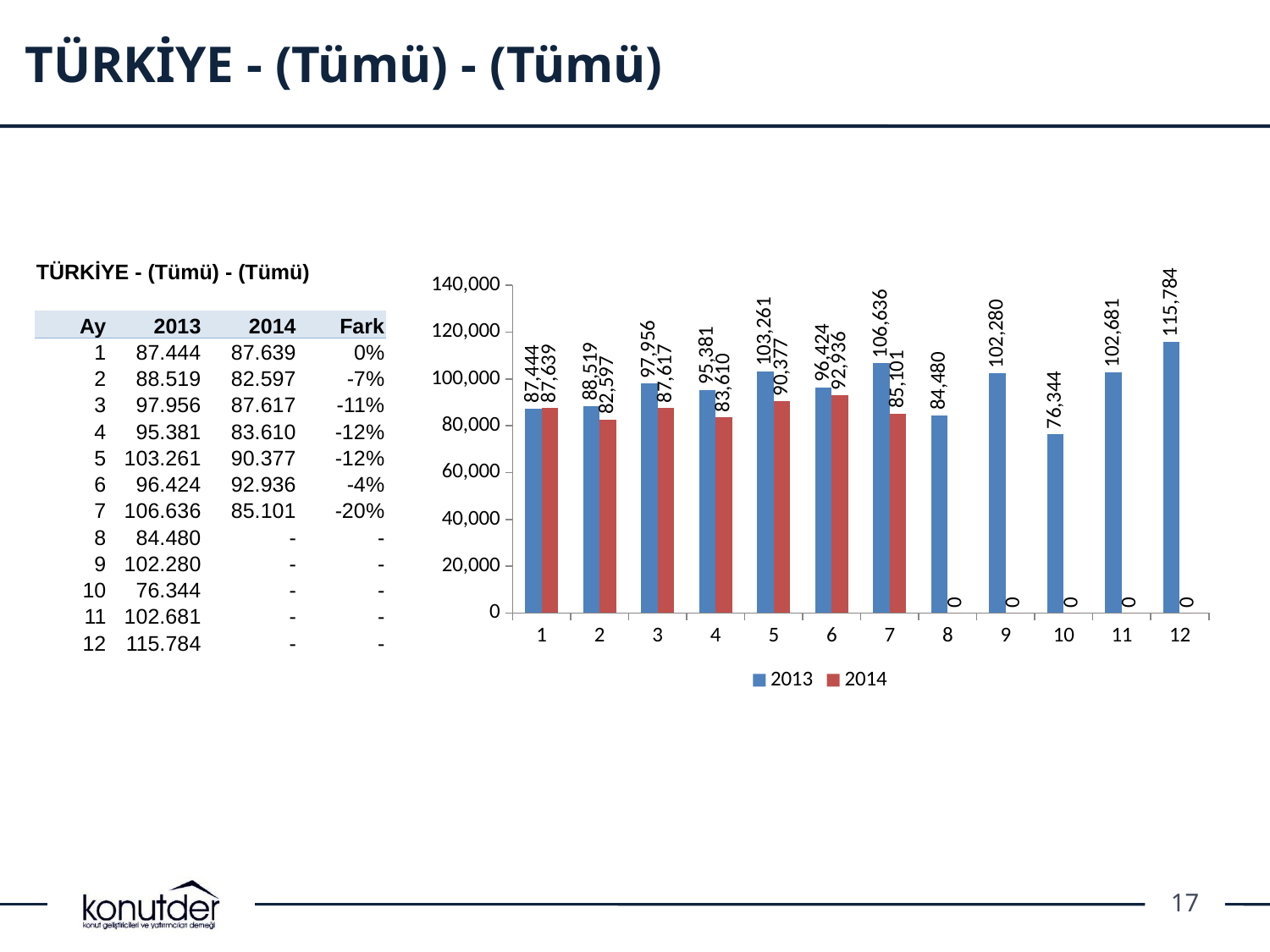
How many series does the legend list? 2 Which month has the lowest 2013 value? 10 Which month has the highest 2014 value? 6 What is the 2014 value for month 5? 90,377 What is the difference between the 2013 and 2014 values for month 7? 21,535 What is the 2013 value for month 12? 115,784 For month 3, which series has the larger value, 2013 or 2014? 2013 How many months are shown on the x axis? 12 Among months 1 to 7, which month has the lowest 2014 value? 2 Is the 2013 value for month 10 greater or less than 80,000? less Which month has the highest 2013 value? 12 What kind of chart is shown on the slide? bar chart